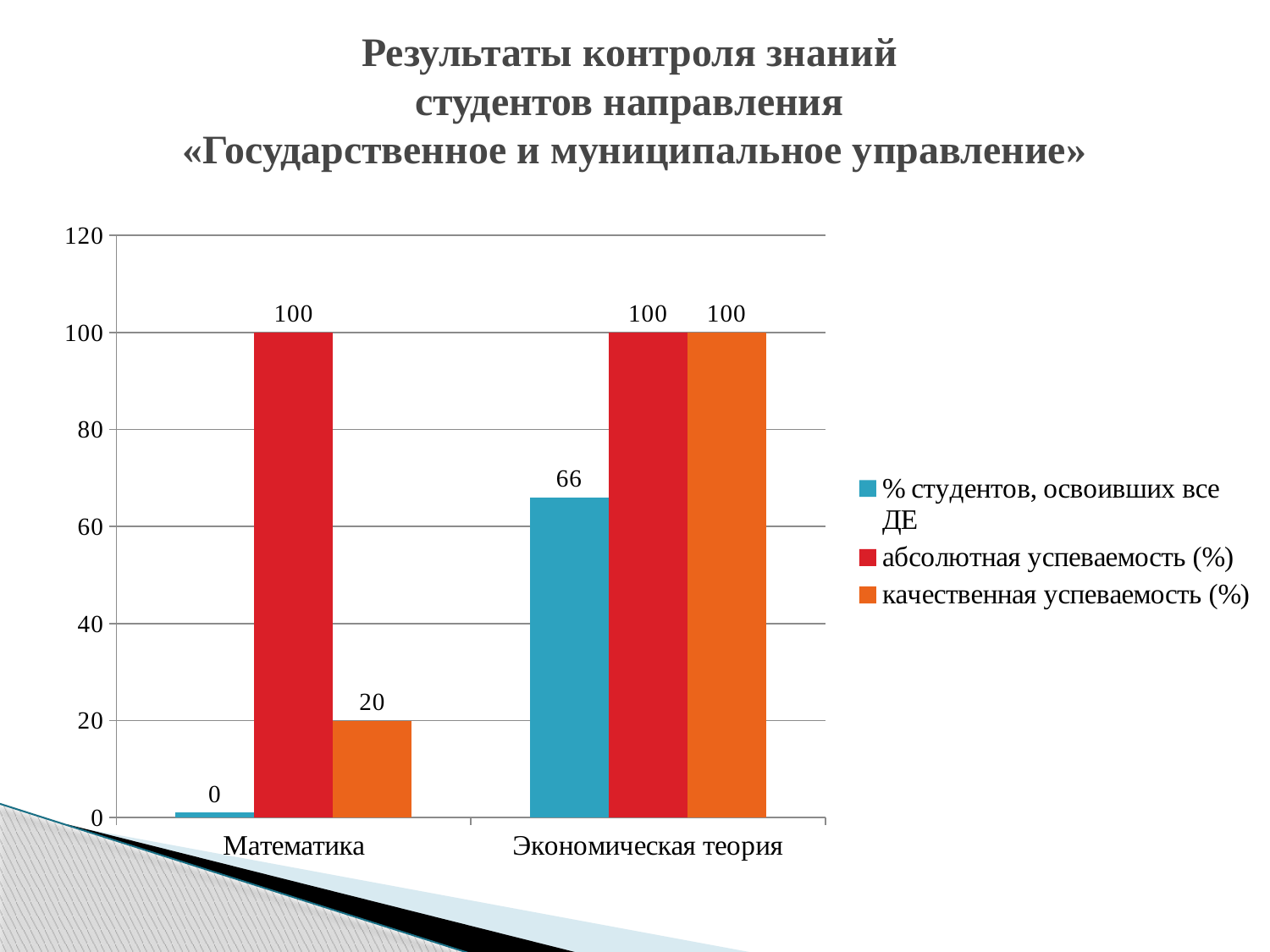
What is the difference between «абсолютная успеваемость (%)» and «% студентов, освоивших все ДЕ» for Экономическая теория? 34 What is the value of «качественная успеваемость (%)» for Математика? 20 How many series does the legend list? 3 What kind of chart is shown on the slide? Bar chart What is the value of «% студентов, освоивших все ДЕ» for Экономическая теория? 66 What is the difference between «качественная успеваемость (%)» for Экономическая теория and for Математика? 80 How many categories are shown on the x axis? 2 Which colour represents «абсолютная успеваемость (%)» in the legend? Red What is the value of «% студентов, освоивших все ДЕ» for Математика? 0 Which is larger: «% студентов, освоивших все ДЕ» for Математика or for Экономическая теория? Экономическая теория What is the value of «абсолютная успеваемость (%)» for Экономическая теория? 100 Which category has the lower value for «качественная успеваемость (%)»? Математика